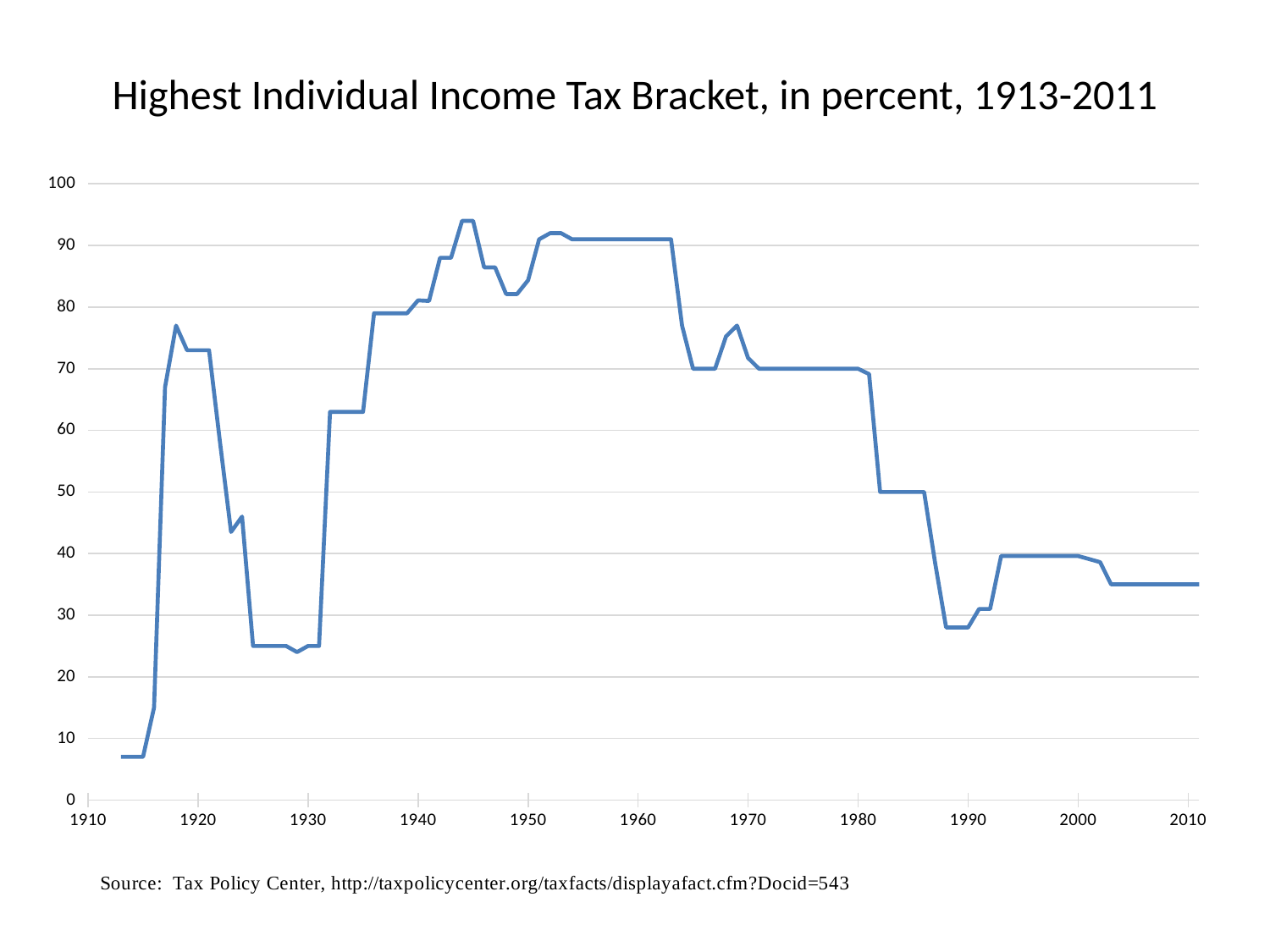
Is the value for 1913 greater or less than 10? less Is the value for 1945 greater or less than 90? greater Which is larger, the value for 1920 or the value for 1930? 1920 Is the value for 1935 greater or less than 60? greater Does the line rise or fall between 1980 and 1990? fall What kind of chart is shown on the slide? line chart Which is larger, the value for 1955 or the value for 2000? 1955 What is the title of the chart? Highest Individual Income Tax Bracket, in percent, 1913-2011 Does the line rise or fall between 1913 and 1918? rise